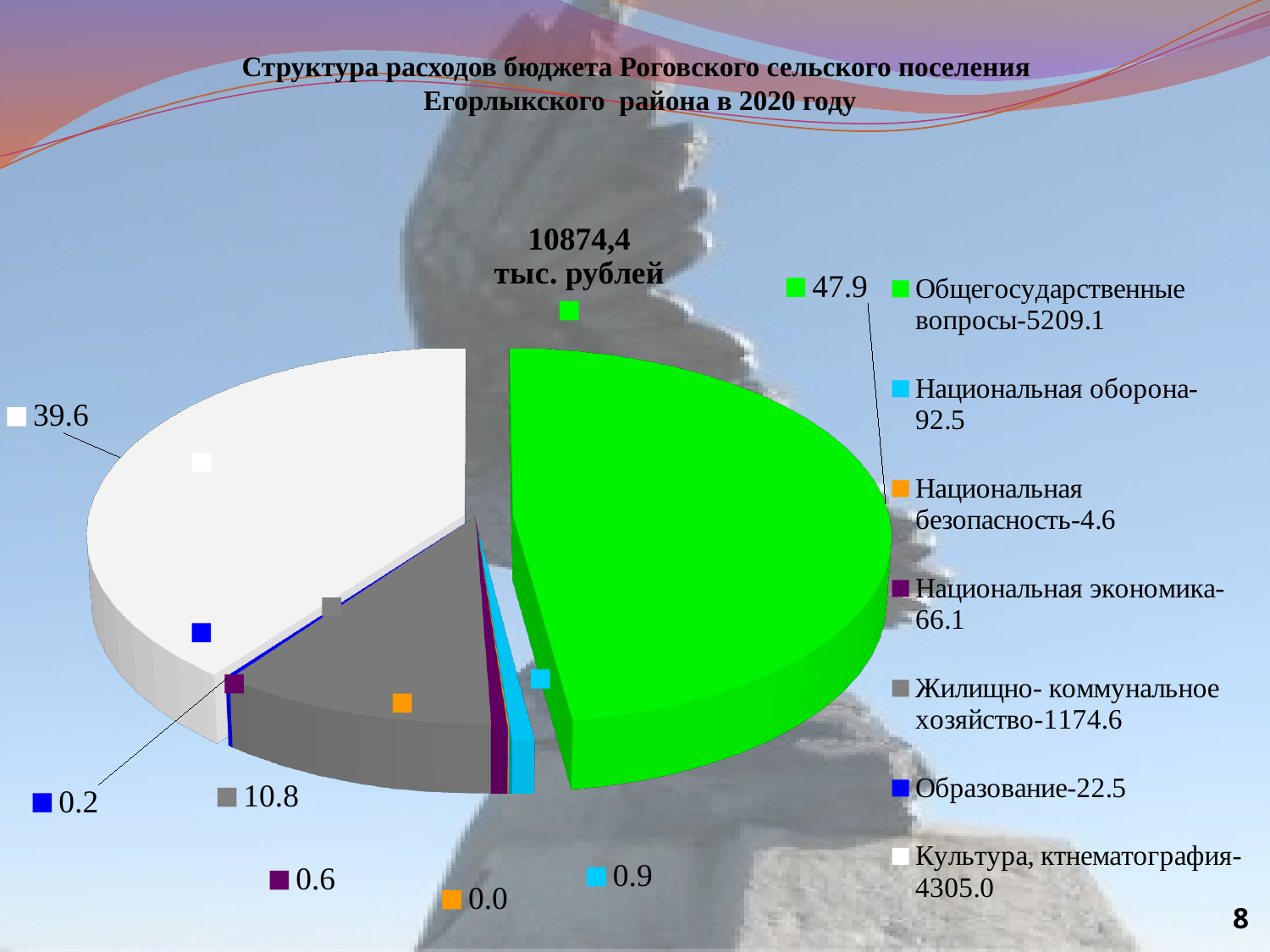
Which category has the smallest share of the pie? Национальная безопасность What kind of chart is shown on the slide? pie chart Which has a larger share: Жилищно-коммунальное хозяйство or Национальная экономика? Жилищно-коммунальное хозяйство Which category has the largest share of the pie? Общегосударственные вопросы How many slices does the pie chart have? 7 What percentage share is shown for Национальная оборона? 0.9 What percentage share is shown for Культура, кинематография? 39.6 What amount in thousand rubles is listed in the legend for Образование? 22.5 What percentage share is shown for Общегосударственные вопросы? 47.9 What percentage share is shown for Жилищно-коммунальное хозяйство? 10.8 What is the difference in percentage points between Общегосударственные вопросы (47.9) and Культура, кинематография (39.6)? 8.3 What total amount is printed above the pie chart? 10874,4 тыс. рублей